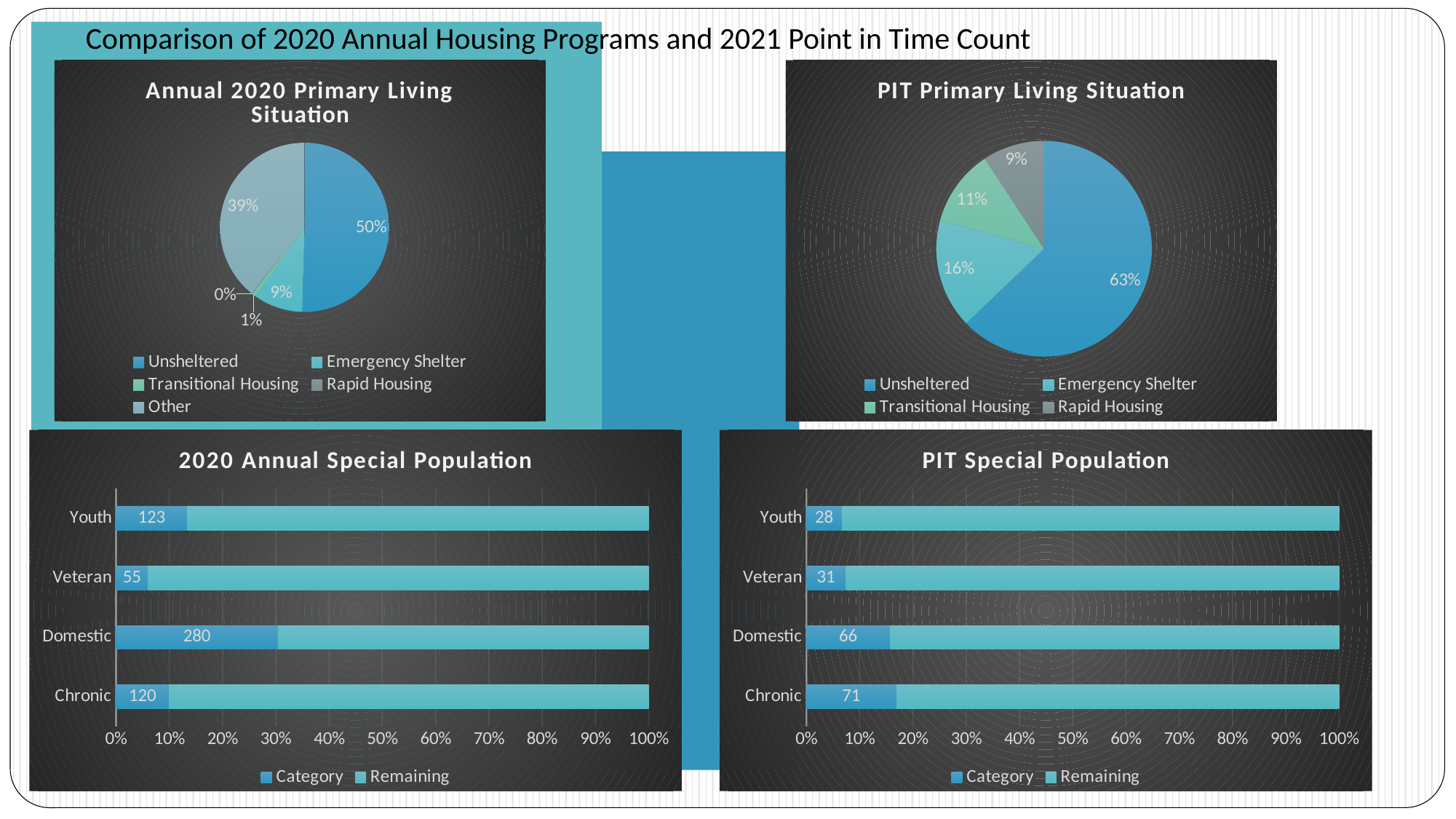
In the PIT Special Population chart, what is the difference between the Category values for Domestic and Youth? 38 In the Annual 2020 Primary Living Situation chart, what share of the pie is Unsheltered? 50% In the 2020 Annual Special Population chart, what is the Category value for Domestic? 280 What kind of chart is the 2020 Annual Special Population chart? Bar chart In the PIT Primary Living Situation chart, what percentage is shown for Emergency Shelter? 16% In the 2020 Annual Special Population chart, which category has the lowest Category value? Veteran In the PIT Primary Living Situation chart, which category has the smallest slice? Rapid Housing How many entries does the legend of the Annual 2020 Primary Living Situation chart list? 5 In the Annual 2020 Primary Living Situation chart, what percentage is shown for Other? 39% How many categories are shown on the y axis of the PIT Special Population chart? 4 In the PIT Special Population chart, what is the Category value for Chronic? 71 In the PIT Primary Living Situation chart, which category has the largest slice? Unsheltered